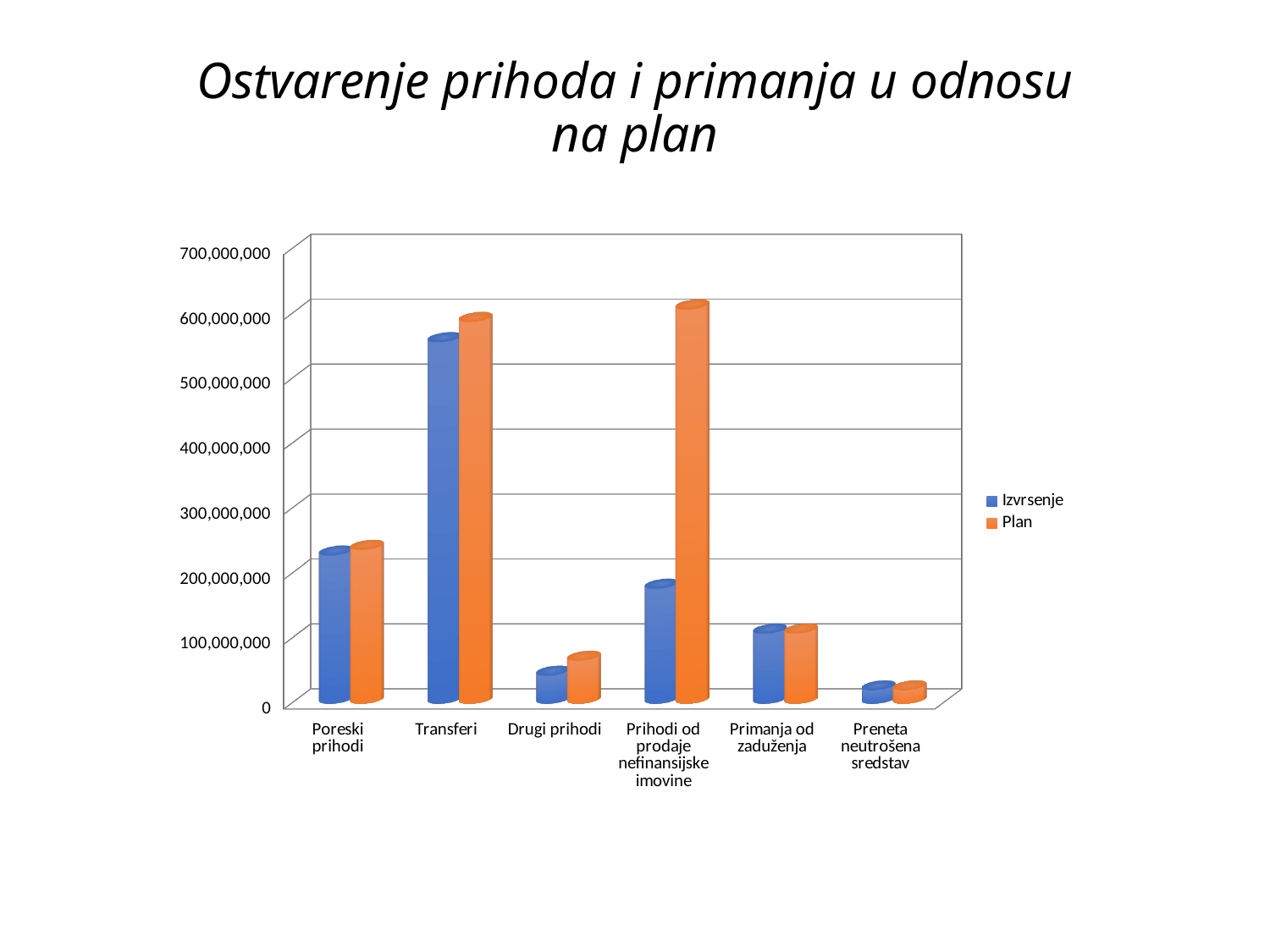
Is the Plan value for Drugi prihodi greater or less than 100,000,000? less How many categories are shown on the x axis? 6 Which category has the lowest Izvrsenje value? Preneta neutrošena sredstav What kind of chart is shown on the slide? Bar chart Is the Izvrsenje value for Poreski prihodi greater or less than 200,000,000? greater Which colour represents the Plan series in the legend? Orange Is the Plan value for Prihodi od prodaje nefinansijske imovine greater or less than 500,000,000? greater How many series does the legend list? 2 For Prihodi od prodaje nefinansijske imovine, which is larger: Izvrsenje or Plan? Plan What is the title of the chart on the slide? Ostvarenje prihoda i primanja u odnosu na plan Which category has the highest Izvrsenje value? Transferi